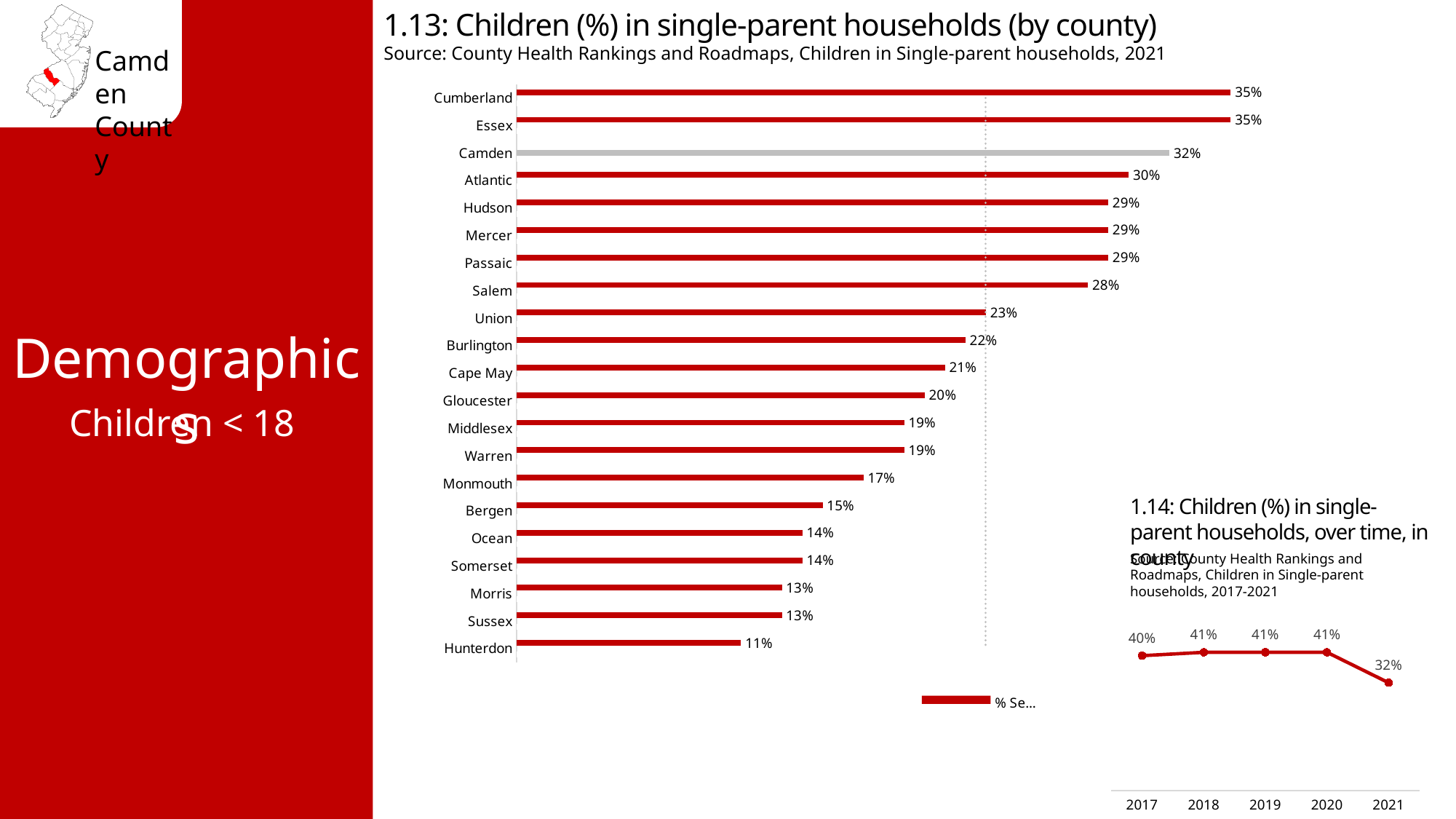
In chart 1.13 (by county), what is the difference between the values for Camden and Hunterdon? 21% In chart 1.13 (by county), what is the value for Atlantic? 30% In chart 1.13 (by county), which county has the lowest value? Hunterdon In chart 1.13 (by county), which is larger, the value for Salem or the value for Union? Salem What kind of chart is chart 1.14 (Children in single-parent households over time)? Line chart In chart 1.13 (by county), how many counties are shown? 21 In chart 1.13 (by county), what is the value for Hunterdon? 11% In chart 1.13 (Children in single-parent households by county), what is the value for Camden? 32% What kind of chart is chart 1.13 (Children in single-parent households by county)? Bar chart In chart 1.14 (over time, in county), what is the value for 2021? 32% In chart 1.14 (over time, in county), what is the value for 2017? 40% In chart 1.14 (over time, in county), what is the difference between the values for 2020 and 2021? 9%